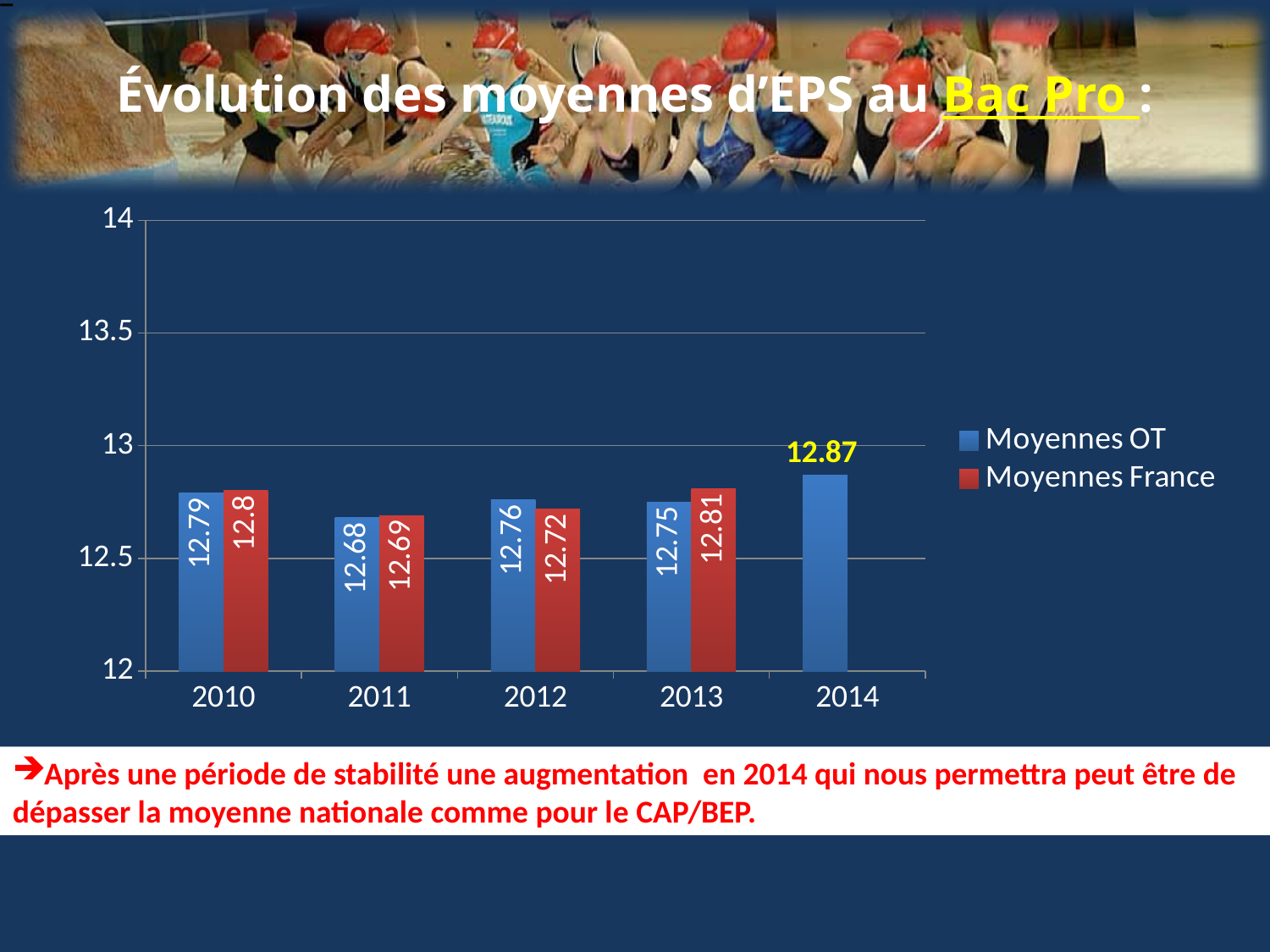
What is the difference between Moyennes France and Moyennes OT in 2013? 0.06 How many years are shown on the x axis? 5 How many series does the legend list? 2 Is the value for Moyennes OT in 2014 greater or less than 13? less In which year is the Moyennes OT value highest? 2014 What is the value for Moyennes France in 2013? 12.81 What is the value for Moyennes OT in 2014? 12.87 What kind of chart is shown on the slide? bar chart Which is larger in 2012, Moyennes OT or Moyennes France? Moyennes OT What is the value for Moyennes France in 2011? 12.69 What is the value for Moyennes OT in 2010? 12.79 In which year is the Moyennes OT value lowest? 2011